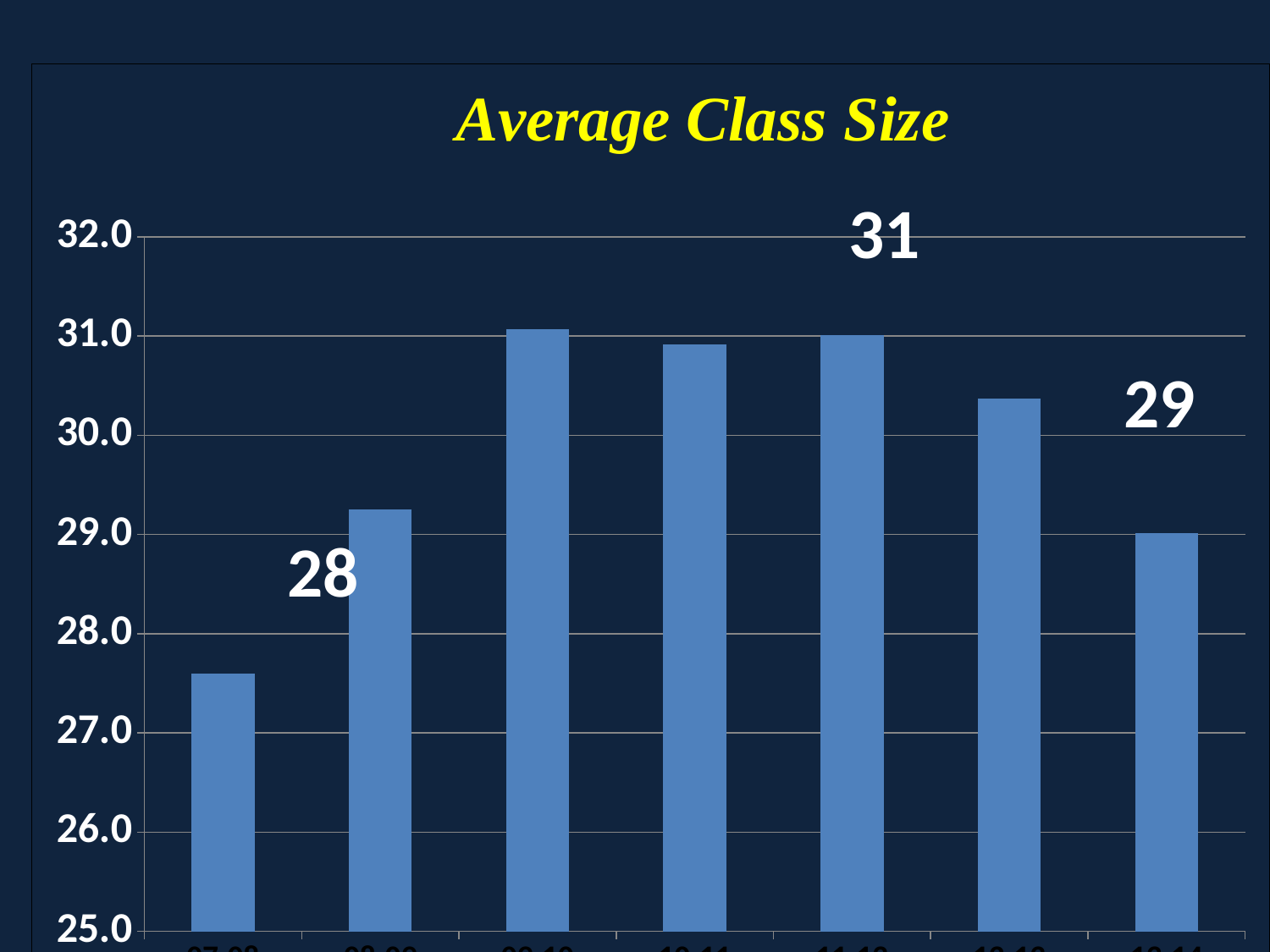
Do the values rise or fall from the fifth bar to the seventh bar? fall Is the value of the second bar greater or less than 29.0? greater What is the highest value shown on the vertical axis? 32.0 Which is larger, the sixth bar or the seventh bar? the sixth bar Which bar is the lowest in the chart? the first bar Is the value of the first bar greater or less than 28.0? less What kind of chart is shown on the slide? bar chart How many bars are plotted in the chart? 7 What is the title of the chart? Average Class Size Is the value of the sixth bar greater or less than 30.0? greater Which is larger, the first bar or the second bar? the second bar